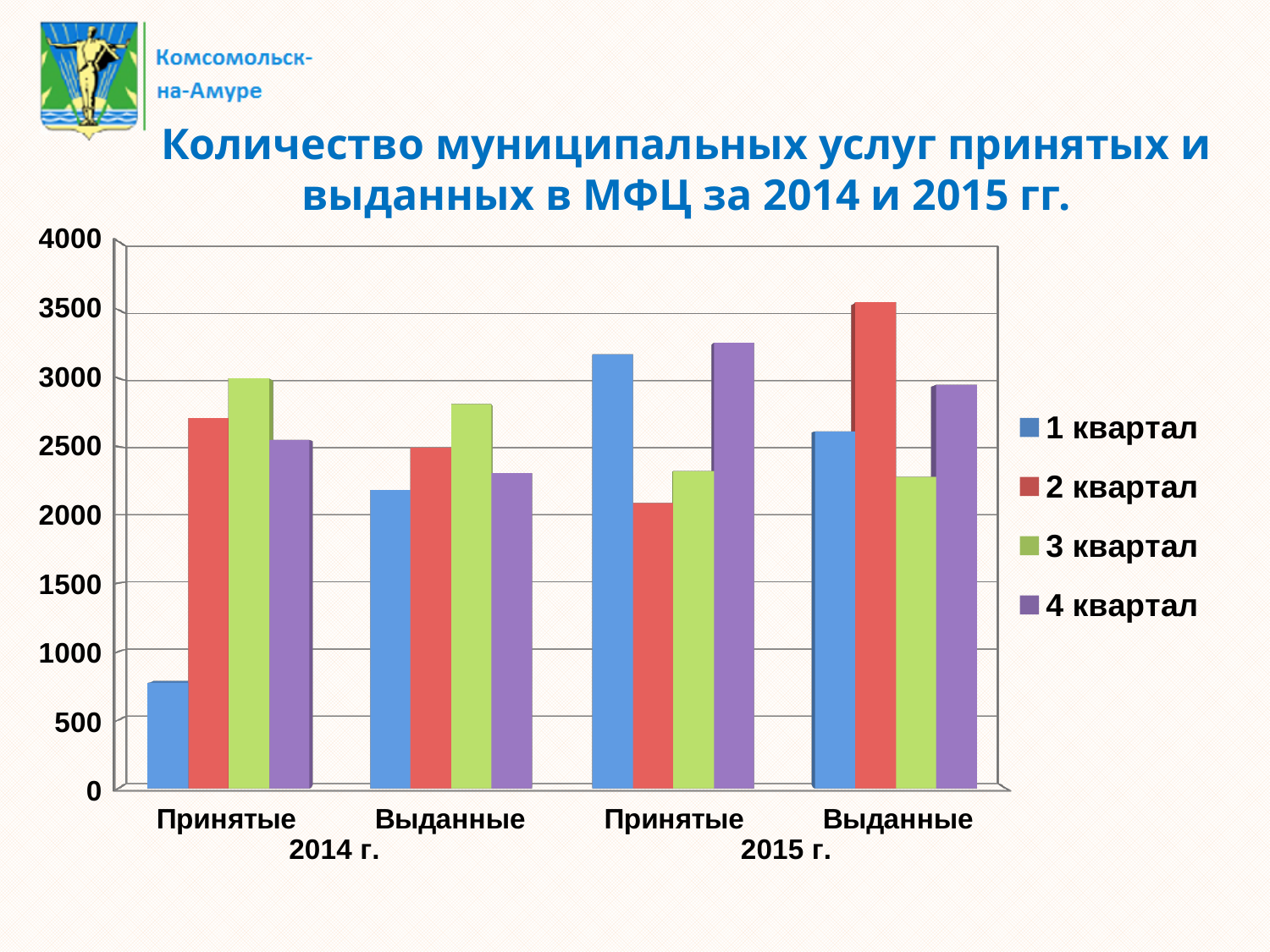
Is the value for 1 квартал in Принятые 2014 г. greater or less than 1000? less How many category groups are shown along the x axis? 4 Is the value for 2 квартал in Выданные 2015 г. greater or less than 3000? greater In Принятые 2014 г., which is larger: 1 квартал or 3 квартал? 3 квартал What are the entries listed in the legend? 1 квартал, 2 квартал, 3 квартал, 4 квартал What kind of chart is shown on the slide? Bar chart How many series does the legend list? 4 Which bar is the highest in the whole chart? 2 квартал, Выданные 2015 г. In Принятые 2015 г., which is larger: 1 квартал or 2 квартал? 1 квартал In Выданные 2014 г., which quarter has the highest value? 3 квартал Is the value for 4 квартал in Принятые 2015 г. greater or less than 3000? greater Which bar is the lowest in the whole chart? 1 квартал, Принятые 2014 г.